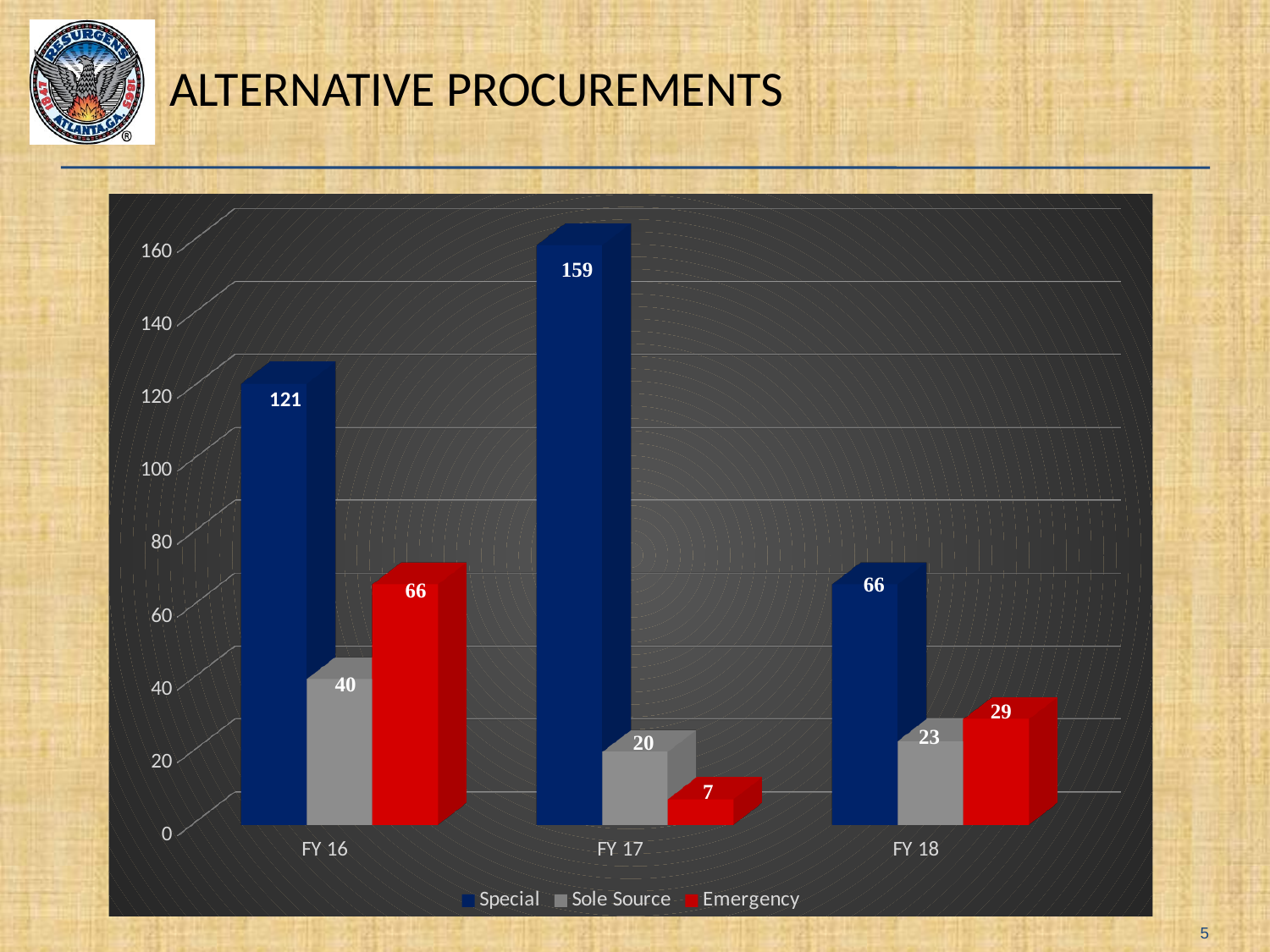
What is the difference between the Special values for FY 17 and FY 18? 93 What is the value for Emergency in FY 18? 29 What is the value for Sole Source in FY 16? 40 Which is larger in FY 18: Sole Source or Emergency? Emergency What kind of chart is shown on the slide? bar chart How many series does the legend list? 3 Does the Sole Source value rise or fall from FY 16 to FY 17? fall Which fiscal year has the lowest Emergency value? FY 17 Which fiscal year has the highest Special value? FY 17 Is the value for Special in FY 16 greater or less than 100? greater What is the value for Special in FY 17? 159 How many fiscal years are shown on the x axis? 3